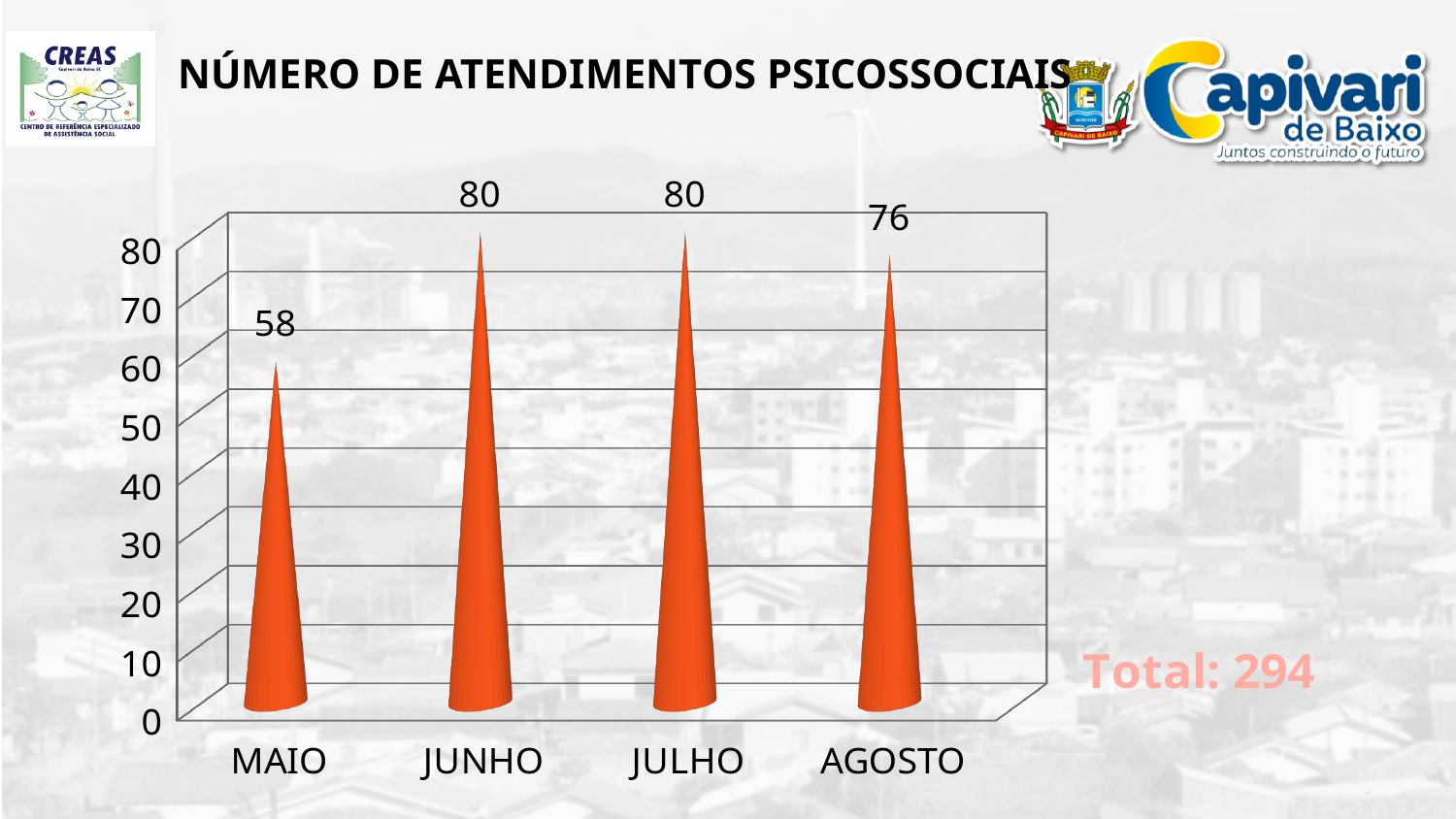
What kind of chart is shown on the slide? bar chart Which is larger, the value for AGOSTO or the value for MAIO? AGOSTO Is the value for MAIO greater or less than 60? less What is the title of the chart? NÚMERO DE ATENDIMENTOS PSICOSSOCIAIS What is the value for MAIO? 58 Which month has the lowest value? MAIO What is the difference between the values for JULHO and AGOSTO? 4 What is the value for JUNHO? 80 How many months are shown on the x axis? 4 What is the difference between the values for JUNHO and MAIO? 22 What total is printed next to the chart? Total: 294 What is the value for AGOSTO? 76